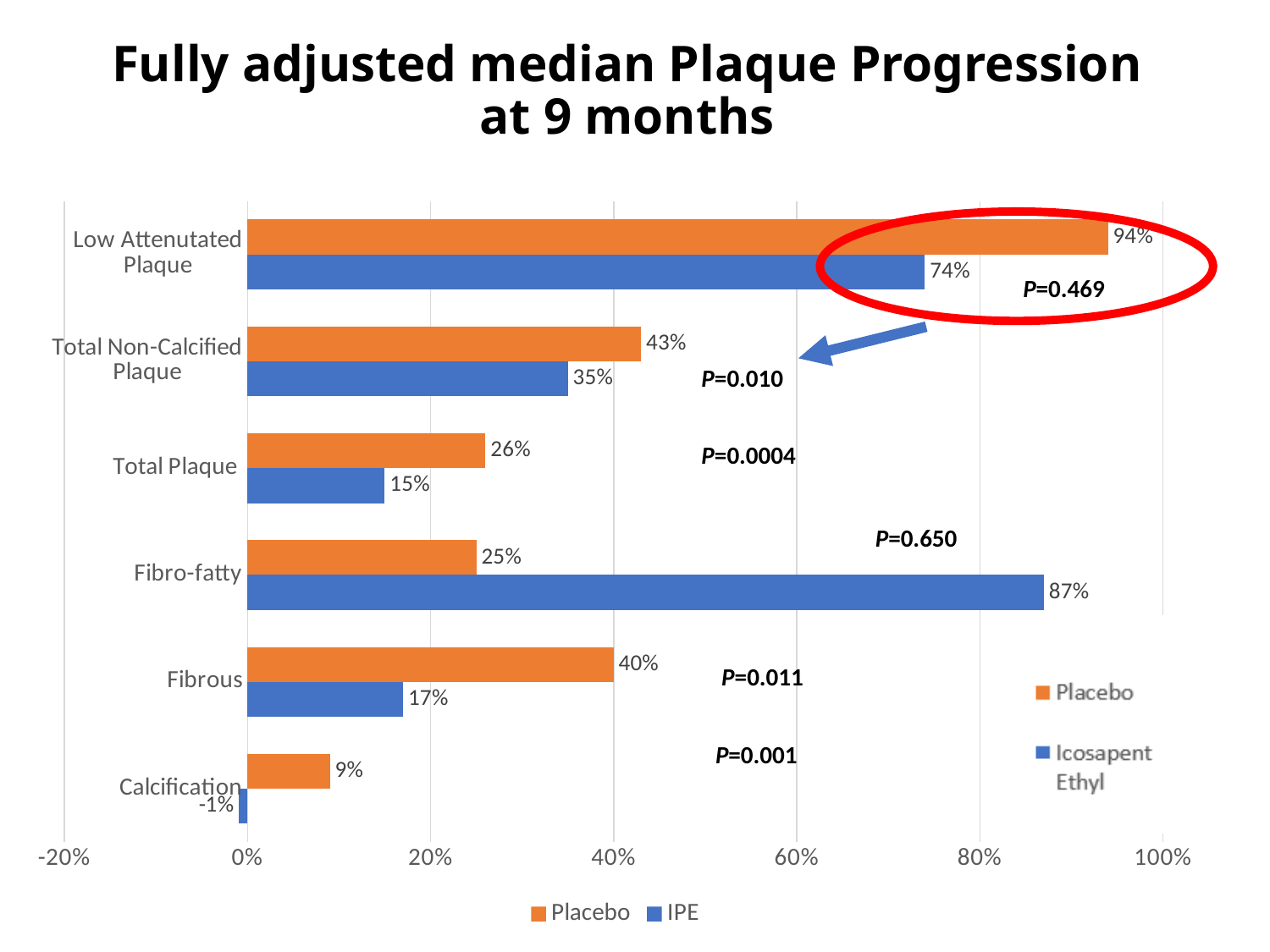
How many plaque categories are shown on the chart? 6 What P value is shown next to the Total Plaque bars? P=0.0004 What is the Placebo value for Calcification? 9% How many series does the legend at the bottom of the chart list? 2 Which category has the highest Placebo value? Low Attenutated Plaque What is the Placebo value for Low Attenutated Plaque? 94% What kind of chart is shown on the slide? Bar chart For Fibro-fatty, which is larger: the Placebo value or the IPE value? IPE What is the IPE value for Total Non-Calcified Plaque? 35% What is the IPE value for Fibro-fatty? 87% Which category has the lowest IPE value? Calcification What is the difference between the Placebo and IPE values for Fibrous? 23%